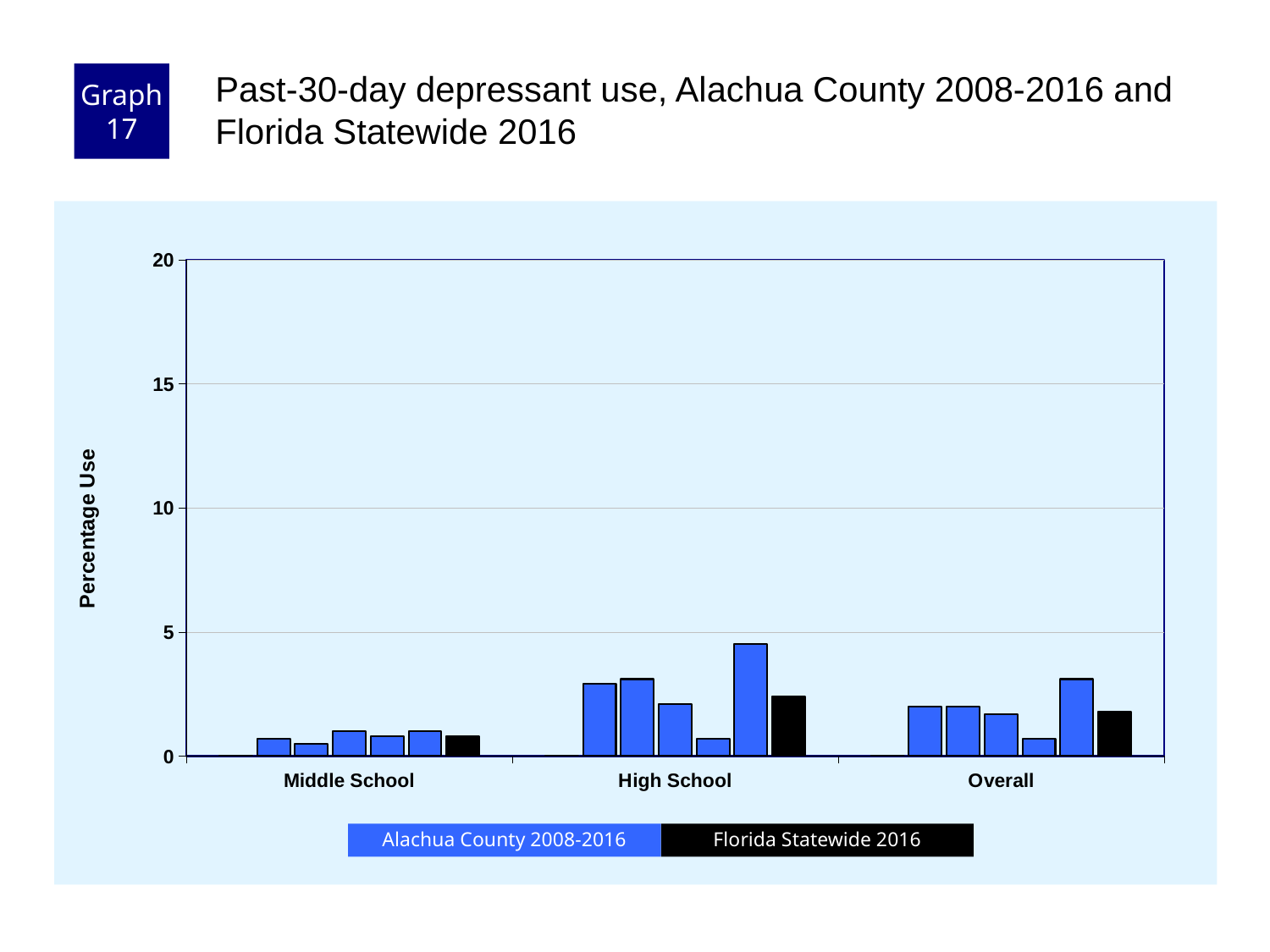
How many categories are shown on the x axis? 3 Is the tallest Alachua County 2008-2016 bar for High School greater or less than 5? less Is the Florida Statewide 2016 value for High School greater or less than 5? less What is the label of the y axis? Percentage Use How many series does the legend list? 2 Which category has the highest Florida Statewide 2016 value? High School Is the Florida Statewide 2016 value for Overall larger or smaller than the Florida Statewide 2016 value for High School? smaller What kind of chart is shown on the slide? bar chart Which category contains the tallest bar in the chart? High School Is the Florida Statewide 2016 value for High School larger or smaller than the Florida Statewide 2016 value for Middle School? larger Which category has the lowest Florida Statewide 2016 value? Middle School Which colour represents Florida Statewide 2016 in the legend? black